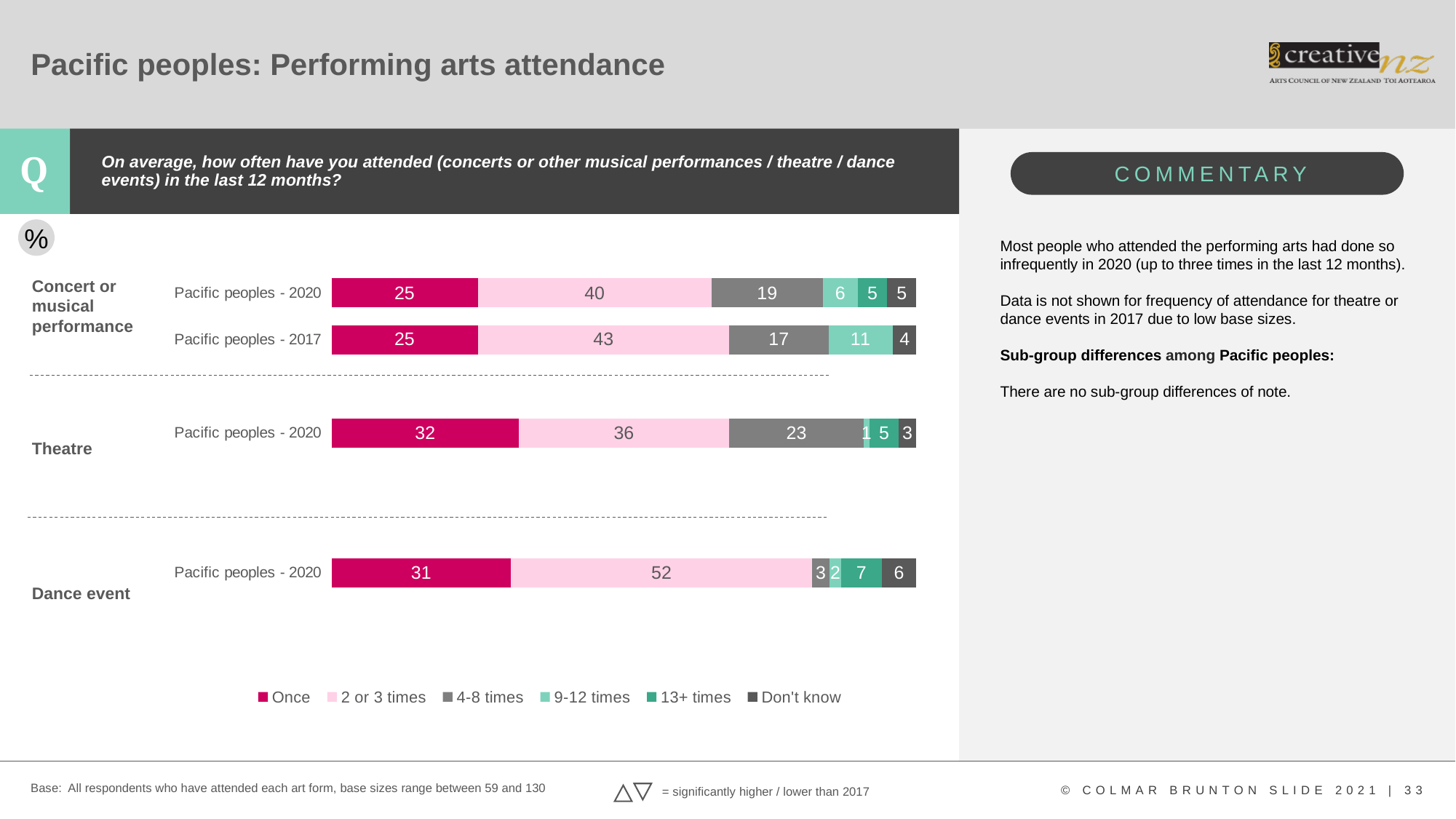
What is the '9-12 times' value for Concert or musical performance, Pacific peoples - 2020? 6 How many series does the legend list? 6 How many bars are plotted in the chart? 4 What is the '4-8 times' value for Concert or musical performance, Pacific peoples - 2017? 17 Among the 2020 bars, which art form has the highest 'Once' value? Theatre What is the total of the stacked bar for Concert or musical performance, Pacific peoples - 2020? 100 What is the 'Don't know' value for Dance event, Pacific peoples - 2020? 6 What kind of chart is shown on the slide? Stacked bar chart Which has the larger '4-8 times' value in 2020: Theatre or Concert or musical performance? Theatre What percentage of Pacific peoples in 2020 attended theatre once? 32 What is the value for '2 or 3 times' for Dance event, Pacific peoples - 2020? 52 How much higher is the '2 or 3 times' value for Concert or musical performance in 2017 than in 2020? 3